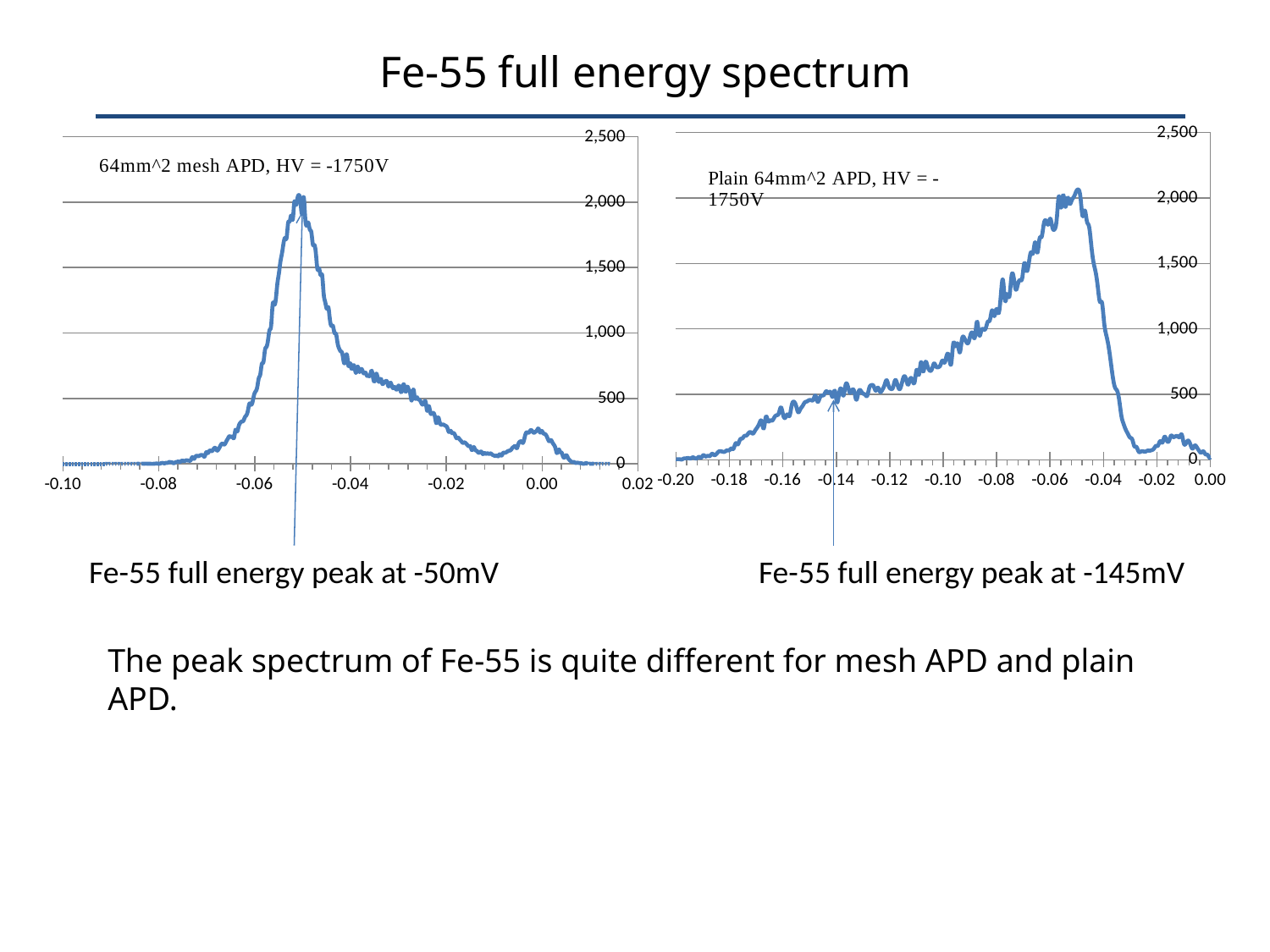
What is the highest tick value shown on the y axis of the left chart (64mm^2 mesh APD)? 2,500 On the left chart (64mm^2 mesh APD), is the peak value of the spectrum greater or less than 1,500? greater On the right chart (Plain 64mm^2 APD), do the values rise or fall along the x axis from -0.18 to -0.08? rise What kind of chart is the left chart (64mm^2 mesh APD)? line chart On the right chart (Plain 64mm^2 APD), which x value has the larger count: -0.06 or -0.14? -0.06 On the left chart (64mm^2 mesh APD), do the values rise or fall along the x axis from -0.05 to -0.02? fall On the left chart (64mm^2 mesh APD), which x value has the larger count: -0.05 or -0.02? -0.05 According to the annotation under the right chart, at what voltage is the Fe-55 full energy peak for the plain APD? -145mV On the right chart (Plain 64mm^2 APD), is the value at -0.02 greater or less than 500? less What kind of chart is the right chart (Plain 64mm^2 APD)? line chart On the right chart (Plain 64mm^2 APD), is the value at -0.14 greater or less than 1,000? less